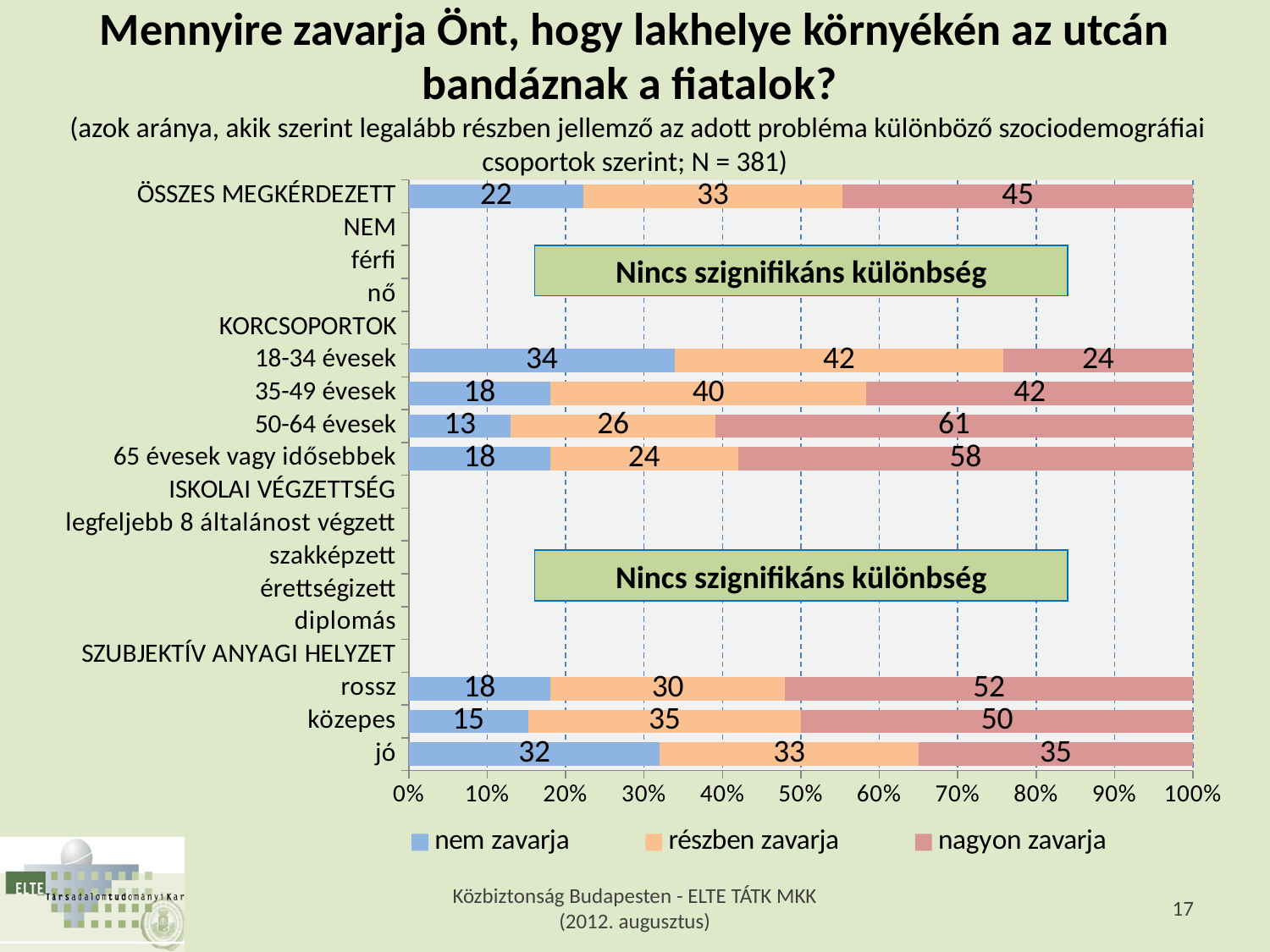
How many series does the legend list? 3 Among the age groups (KORCSOPORTOK), which has the highest "nagyon zavarja" value? 50-64 évesek What is the difference between the "nagyon zavarja" values for 50-64 évesek and 18-34 évesek? 37 What is the value of "nem zavarja" for 18-34 évesek? 34 What is the value of "nagyon zavarja" for ÖSSZES MEGKÉRDEZETT? 45 What text appears in the green boxes placed over the NEM and ISKOLAI VÉGZETTSÉG sections of the chart? Nincs szignifikáns különbség What type of chart is shown on the slide? stacked bar chart Which legend entry is shown in red? nagyon zavarja Which is larger: the "nem zavarja" value for jó or for rossz? jó Among the subjective financial situation categories (rossz, közepes, jó), which has the lowest "nem zavarja" value? közepes What is the value of "részben zavarja" for 65 évesek vagy idősebbek? 24 What is the total of the stacked bar for 35-49 évesek? 100